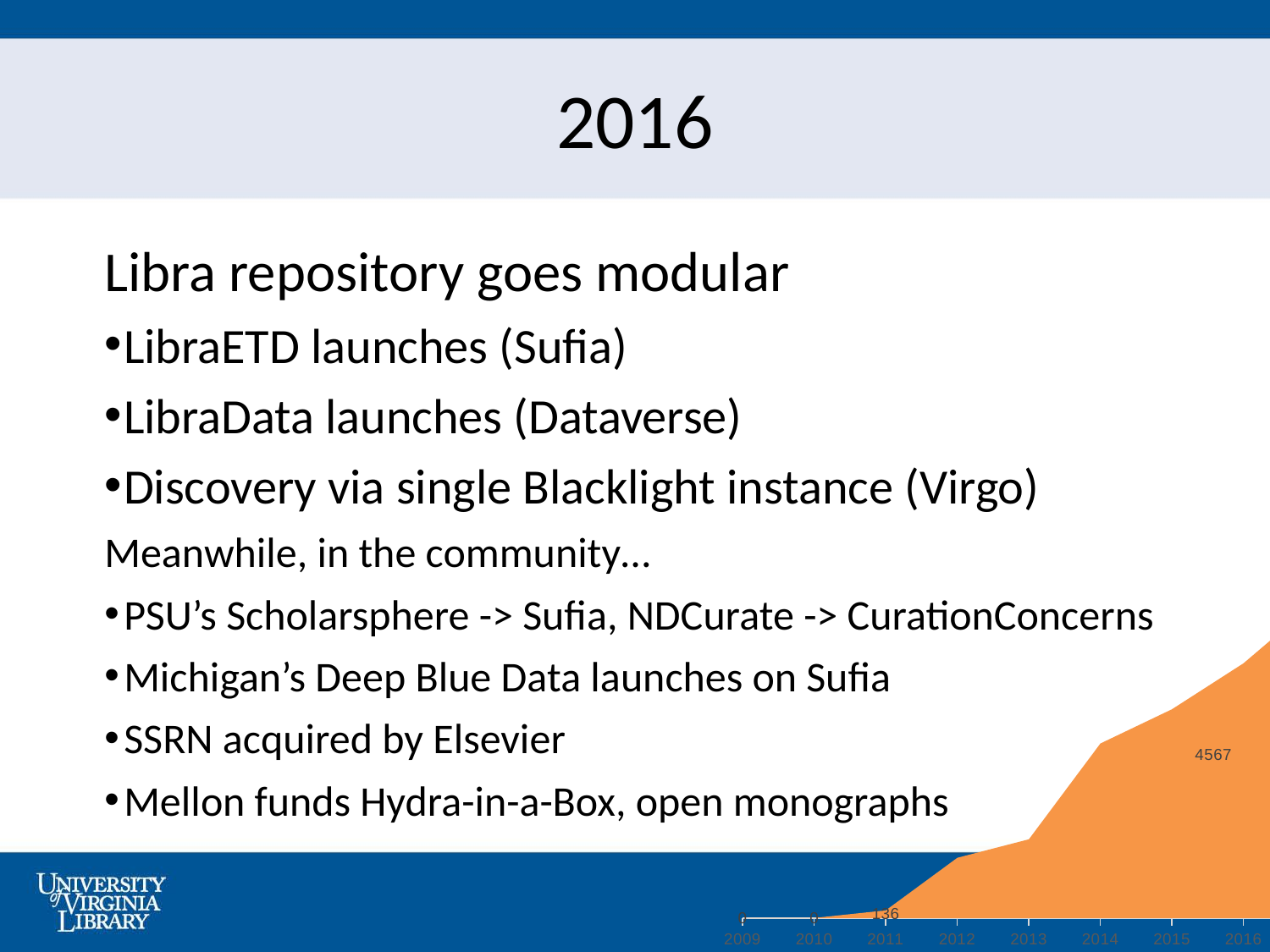
How many years are shown on the x axis of the chart at the bottom right? 8 In the chart at the bottom right, what is the value labelled for 2011? 136 In the chart at the bottom right, which is larger, the value for 2016 or the value for 2011? 2016 In the chart at the bottom right, do the values rise or fall from 2009 to 2016? rise What is the first year shown on the x axis of the chart at the bottom right? 2009 In the chart at the bottom right, which is larger, the value for 2014 or the value for 2012? 2014 What is the largest data label printed on the chart at the bottom right? 4567 What colour is the filled area in the chart at the bottom right? orange What kind of chart is shown at the bottom right of the slide? area chart